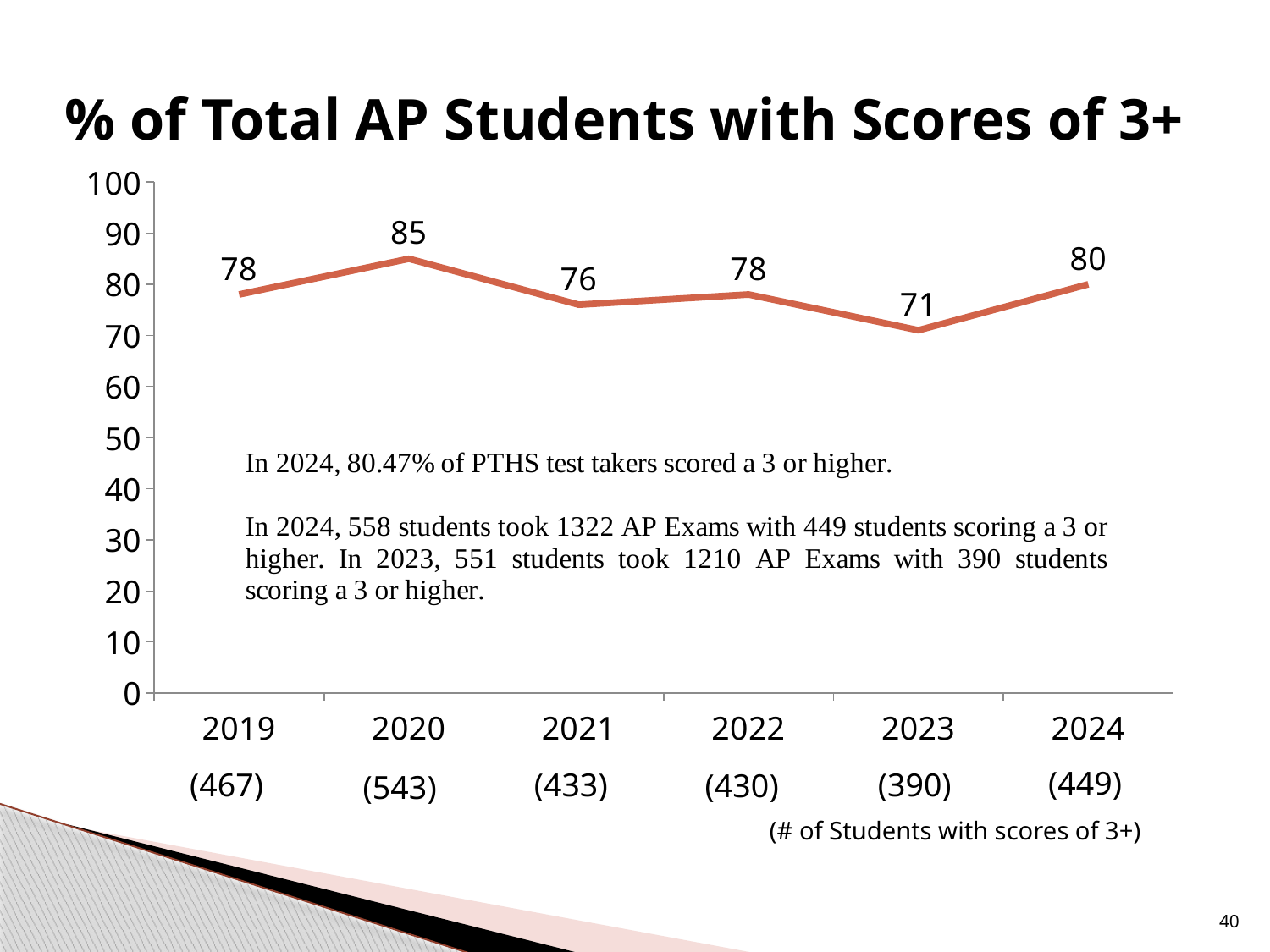
Does the value rise or fall from 2023 to 2024? rise What is the value for 2024? 80 What is the difference between the values for 2020 and 2023? 14 What is the title of the chart? % of Total AP Students with Scores of 3+ What is the value for 2020? 85 Which year has the lowest value? 2023 What kind of chart is shown? line chart Which year has the highest value? 2020 How many years are plotted on the chart? 6 Which is larger, the value for 2019 or the value for 2021? 2019 What is the value for 2023? 71 What is the difference between the values for 2024 and 2023? 9